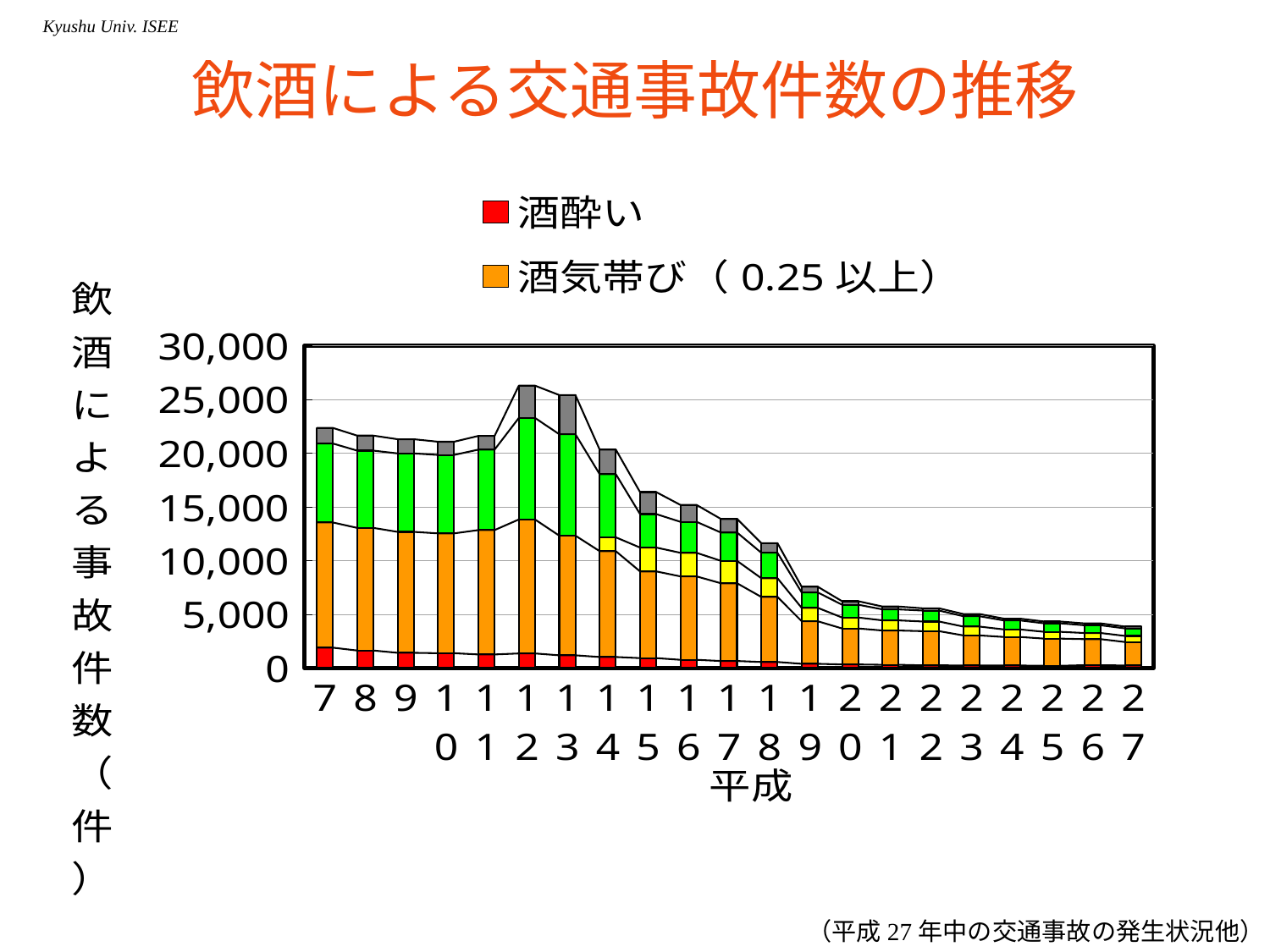
What kind of chart is shown on the slide? bar chart What is the title of the chart? 飲酒による交通事故件数の推移 Do the totals rise or fall from 平成12 to 平成27? fall How many series does the legend list? 2 Is the total for 平成12 greater or less than 25,000? greater Is the total for 平成19 greater or less than 10,000? less Is the total for 平成27 greater or less than 5,000? less Which has the larger total, 平成14 or 平成15? 平成14 How many years (categories) are plotted along the x axis? 21 Which year has the highest total number of accidents? 平成12 What colour represents 酒酔い in the chart? red